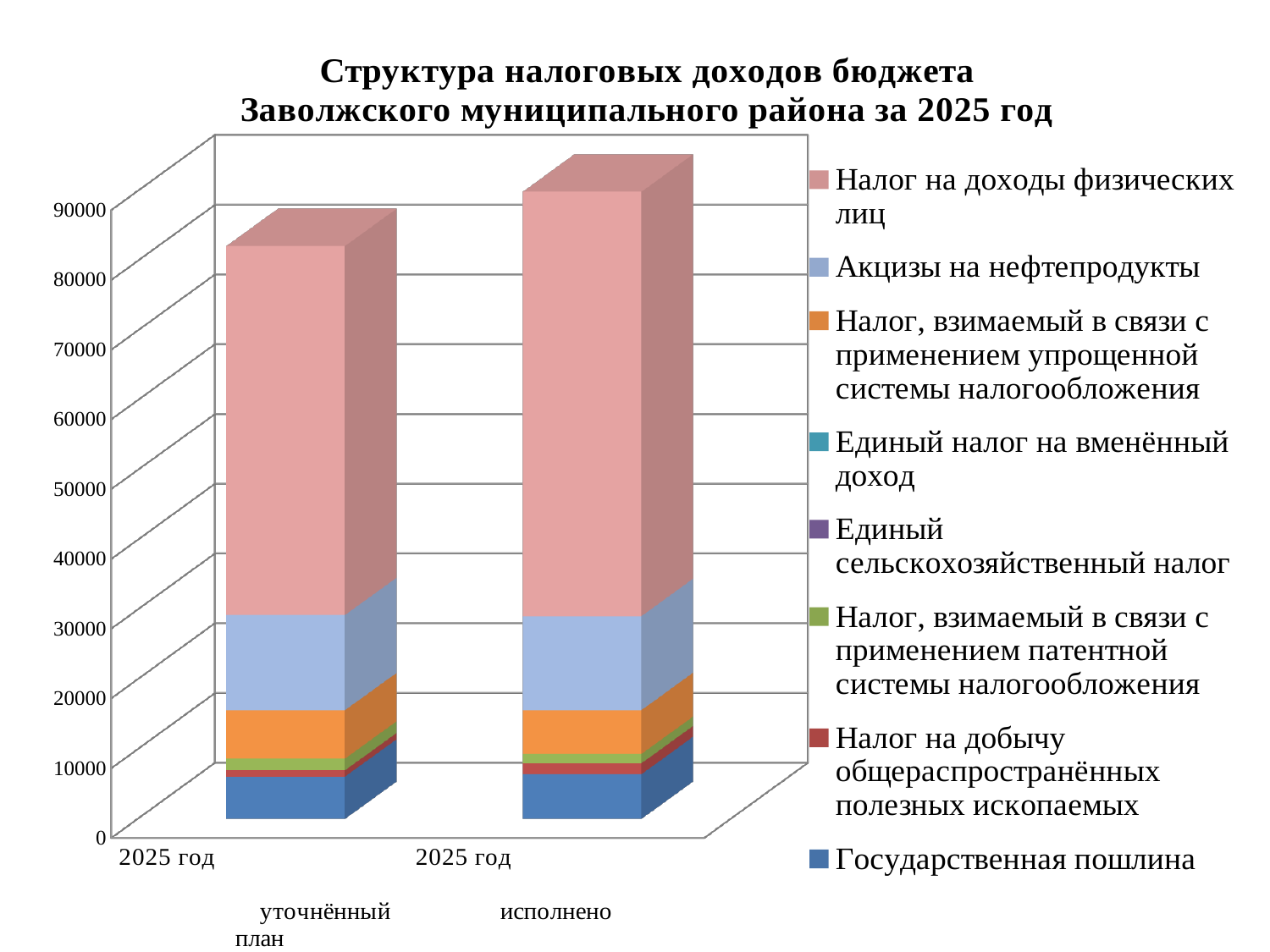
Which bar is taller, "уточнённый план" or "исполнено"? исполнено How many bars are plotted in the chart? 2 Is the total of the "уточнённый план" bar greater or less than 90000? less Is the value of "Налог на доходы физических лиц" in the "исполнено" bar greater or less than 40000? greater What kind of chart is shown on the slide? stacked bar chart Is the total of the "исполнено" bar greater or less than 80000? greater Which series takes up the largest part of each bar? Налог на доходы физических лиц How many series does the legend list? 8 Which series is shown at the bottom of each stacked bar? Государственная пошлина What is the title of the chart? Структура налоговых доходов бюджета Заволжского муниципального района за 2025 год